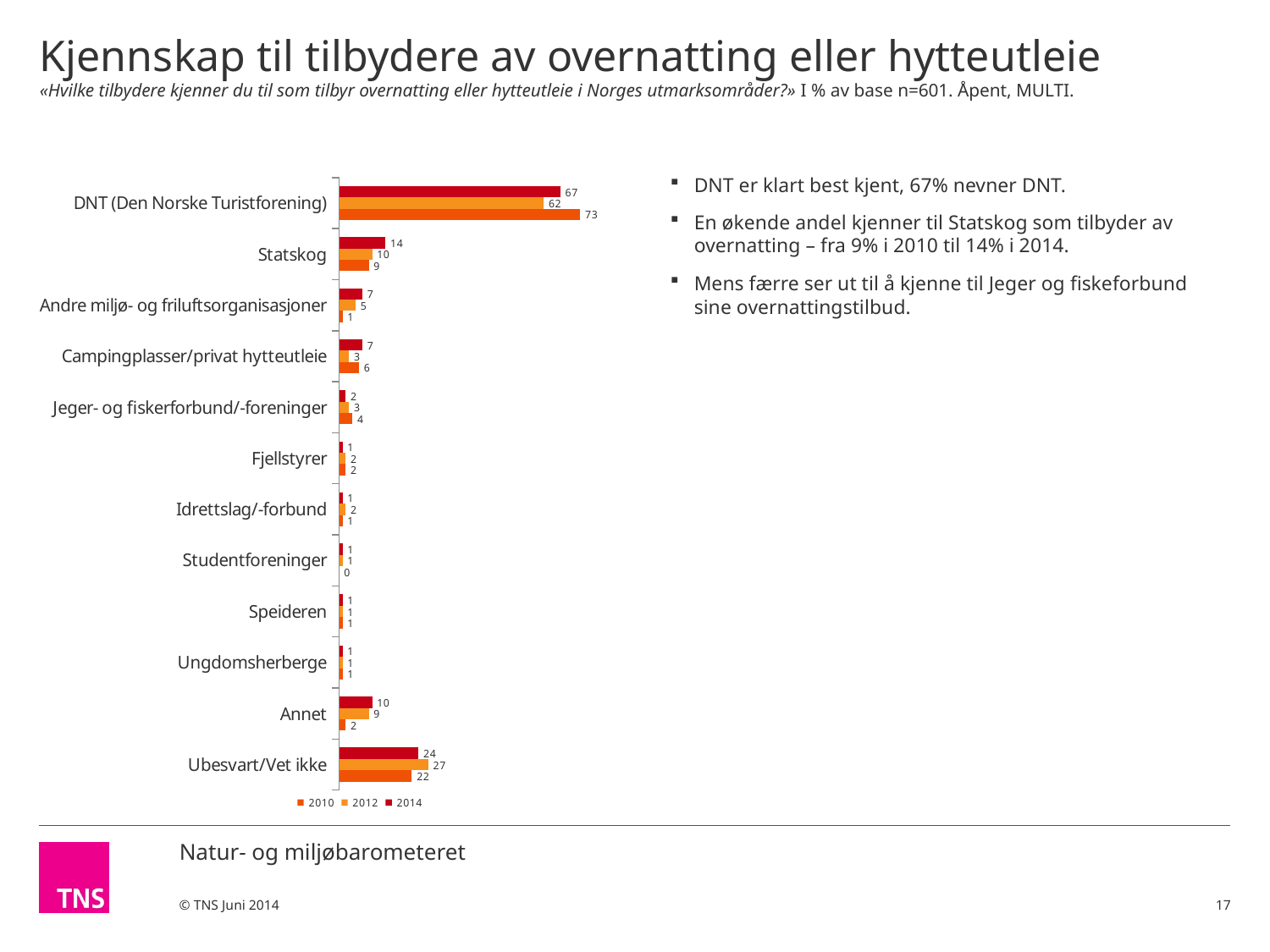
Which category has the highest value in 2014? DNT (Den Norske Turistforening) What is the difference between the 2014 and 2010 values for Statskog? 5 What kind of chart is shown on the slide? Bar chart How many categories are shown on the chart? 12 Which years are listed in the chart legend? 2010, 2012, 2014 What is the value for DNT (Den Norske Turistforening) in 2014? 67 What is the value for Jeger- og fiskerforbund/-foreninger in 2010? 4 What is the value for DNT (Den Norske Turistforening) in 2010? 73 What is the value for Ubesvart/Vet ikke in 2012? 27 Which is larger for Annet: the 2014 value or the 2010 value? 2014 How many series does the legend list? 3 What is the value for Statskog in 2014? 14